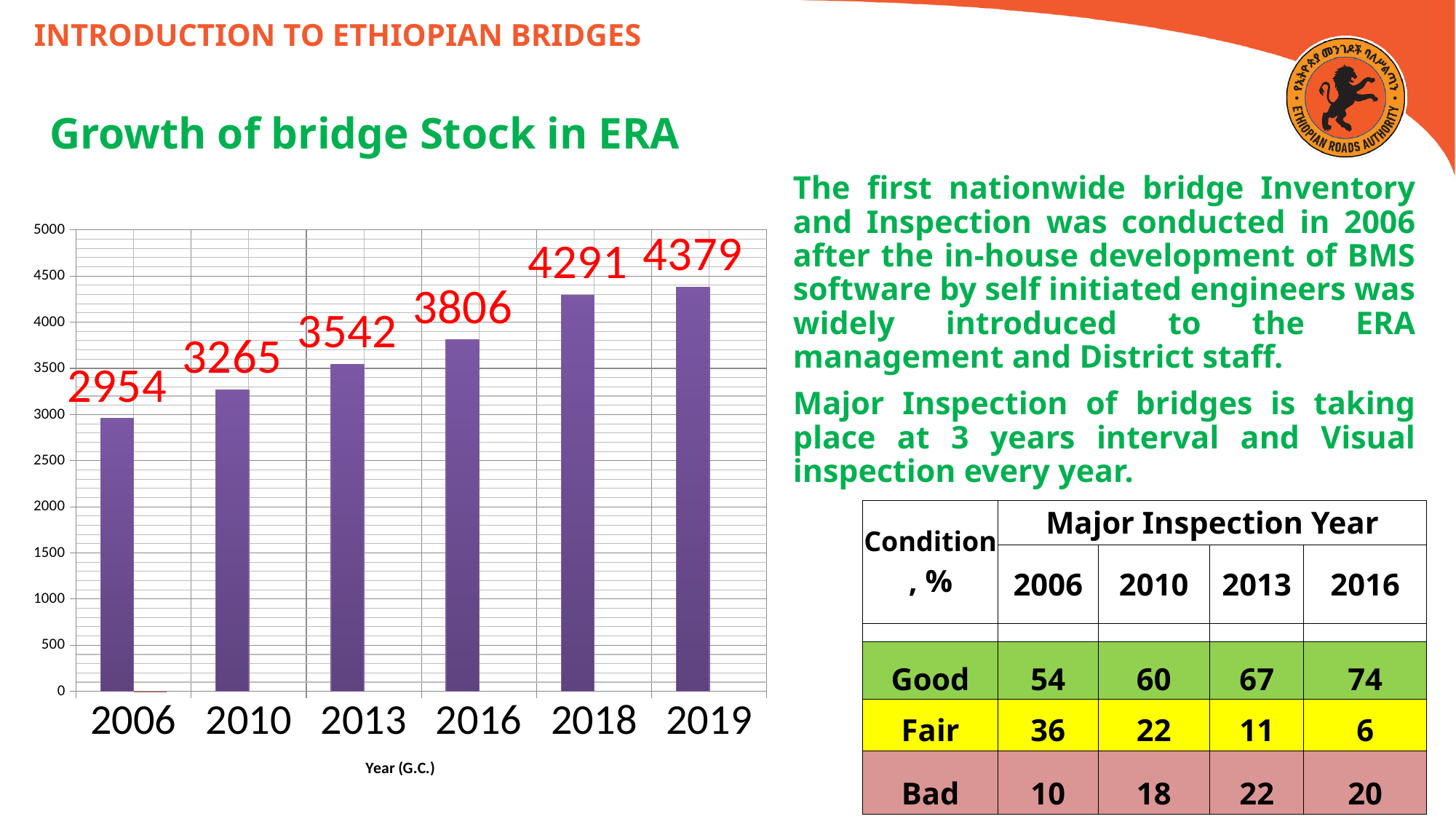
Which year has the lowest bridge stock in the chart? 2006 What is the bridge stock value shown for 2006? 2954 Is the bridge stock value for 2018 greater or less than 4000? greater What is the difference between the bridge stock in 2019 and in 2006? 1425 What is the bridge stock value shown for 2016? 3806 Which is larger, the bridge stock in 2013 or in 2010? 2013 Which year has the highest bridge stock in the chart? 2019 What kind of chart is used to show the growth of bridge stock? bar chart How many years are shown on the x axis of the chart? 6 What is the bridge stock value shown for 2019? 4379 What is the difference between the bridge stock in 2018 and in 2016? 485 Do the bridge stock values rise or fall from 2006 to 2019? rise